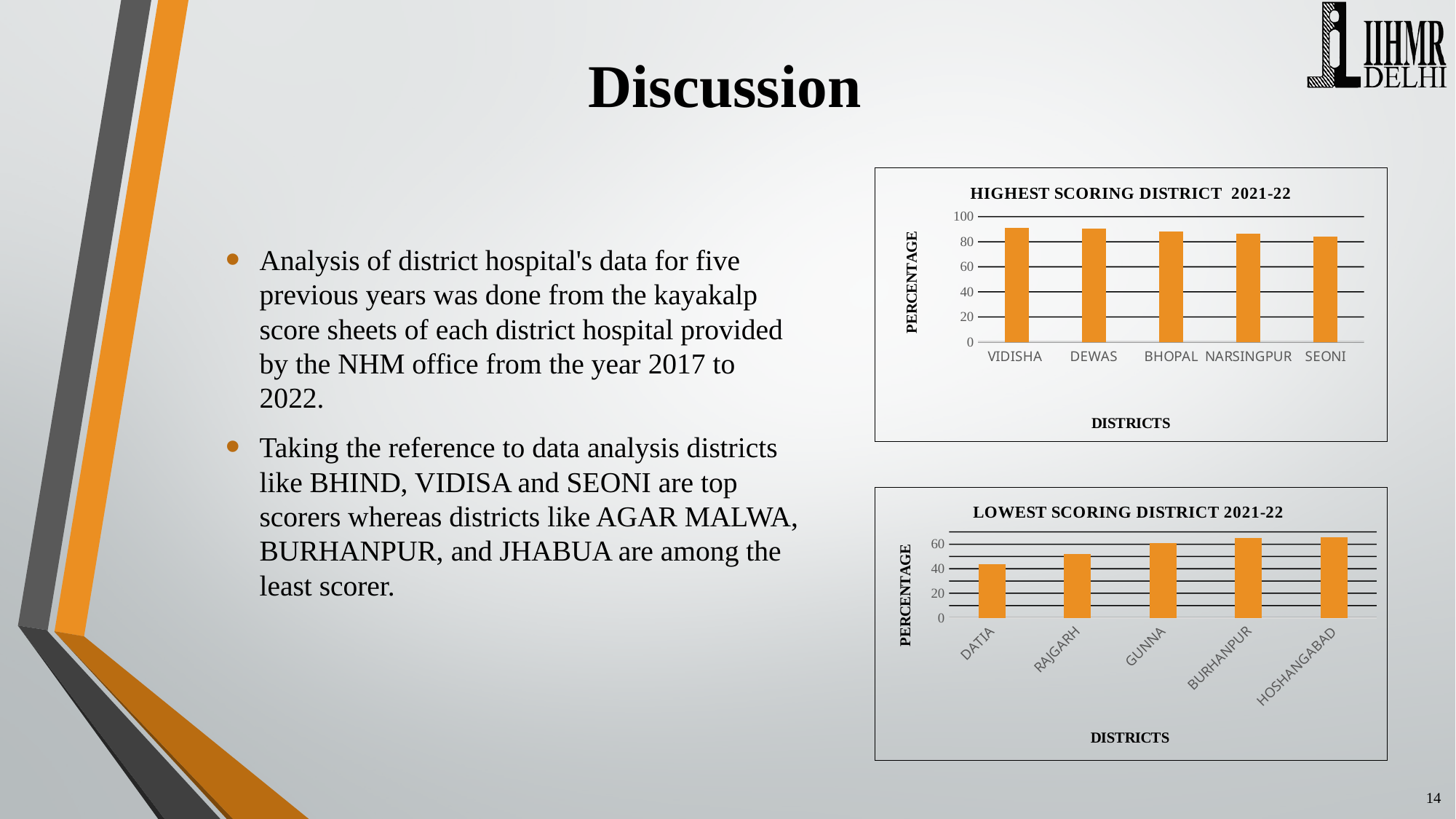
In the 'HIGHEST SCORING DISTRICT 2021-22' chart, which is larger, the value for VIDISHA or the value for SEONI? VIDISHA In the 'HIGHEST SCORING DISTRICT 2021-22' chart, is the value for SEONI greater or less than 100? less In the 'HIGHEST SCORING DISTRICT 2021-22' chart, do the values rise or fall from VIDISHA to SEONI? fall What kind of chart is the 'HIGHEST SCORING DISTRICT 2021-22' chart? bar chart What is the y-axis label of the 'HIGHEST SCORING DISTRICT 2021-22' chart? PERCENTAGE How many districts are shown in the 'HIGHEST SCORING DISTRICT 2021-22' chart? 5 In the 'LOWEST SCORING DISTRICT 2021-22' chart, is the value for DATIA greater or less than 40? greater In the 'LOWEST SCORING DISTRICT 2021-22' chart, is the value for RAJGARH greater or less than 60? less In the 'LOWEST SCORING DISTRICT 2021-22' chart, which district has the lowest value? DATIA How many districts are shown in the 'LOWEST SCORING DISTRICT 2021-22' chart? 5 In the 'LOWEST SCORING DISTRICT 2021-22' chart, do the values rise or fall from DATIA to HOSHANGABAD? rise